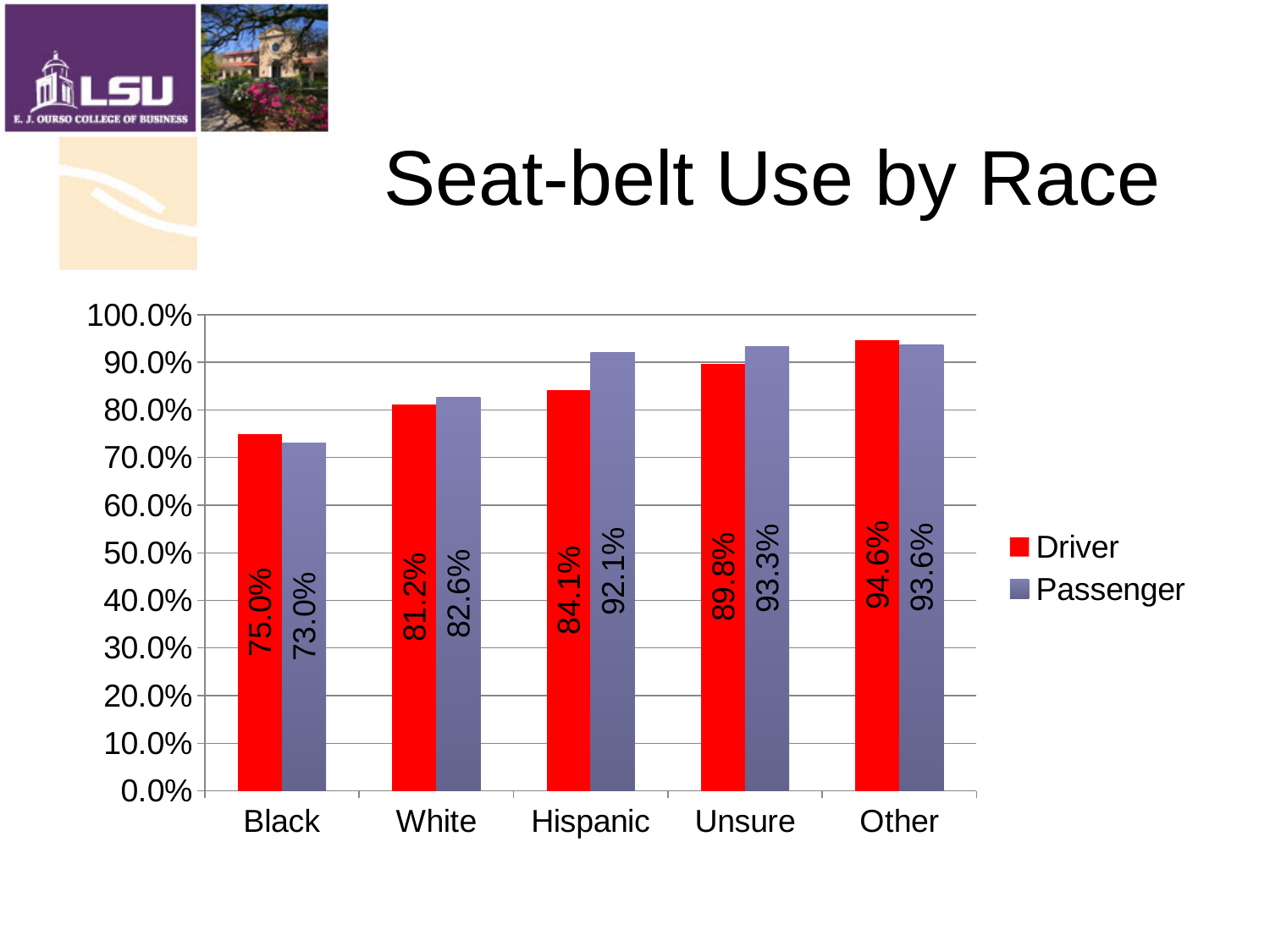
How many series does the legend list? 2 What kind of chart is shown on the slide? Bar chart Which category has the highest Driver value? Other What is the Passenger value for Unsure? 93.3% Is the Driver value for White greater or less than 80.0%? greater Which category has the lowest Passenger value? Black What is the difference between the Passenger and Driver values for Hispanic? 8.0% Do the Driver values rise or fall from Black to Other along the x axis? Rise What is the Passenger seat-belt use value for Hispanic? 92.1% How many race categories are shown on the x axis? 5 What is the Driver seat-belt use value for Black? 75.0% Which is larger for Black, the Driver value or the Passenger value? Driver